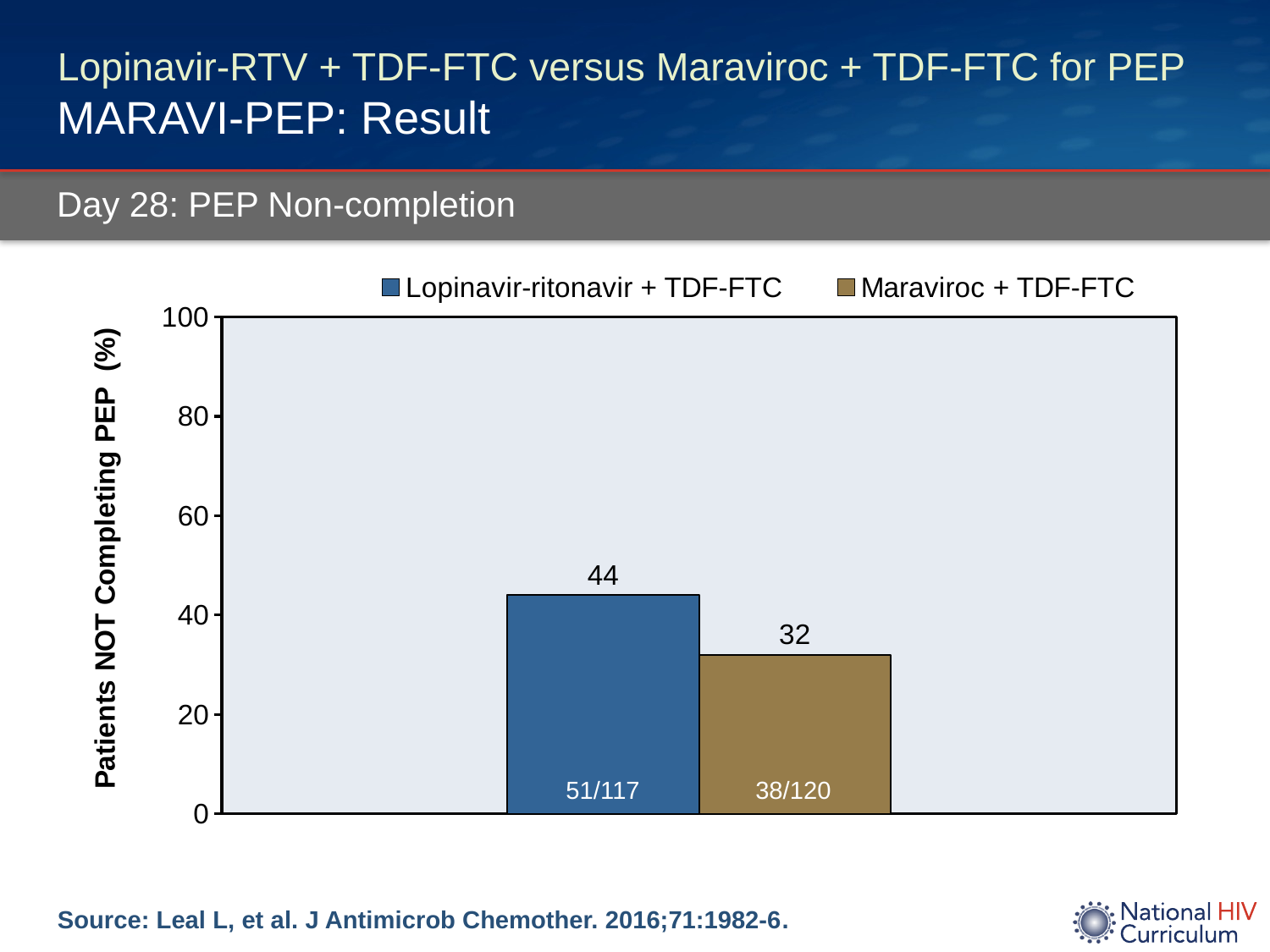
What fraction is printed inside the Maraviroc + TDF-FTC bar? 38/120 How many series does the legend list? 2 What fraction is printed inside the Lopinavir-ritonavir + TDF-FTC bar? 51/117 Is the value for Maraviroc + TDF-FTC greater or less than 40? less Which series has the higher percentage of patients not completing PEP? Lopinavir-ritonavir + TDF-FTC Is the value for Lopinavir-ritonavir + TDF-FTC larger or smaller than the value for Maraviroc + TDF-FTC? larger What is the value for Lopinavir-ritonavir + TDF-FTC? 44 What is the difference between the Lopinavir-ritonavir + TDF-FTC and Maraviroc + TDF-FTC values? 12 What is the label of the y axis? Patients NOT Completing PEP (%) Which series has the lower percentage of patients not completing PEP? Maraviroc + TDF-FTC What is the value for Maraviroc + TDF-FTC? 32 What kind of chart is shown on the slide? bar chart